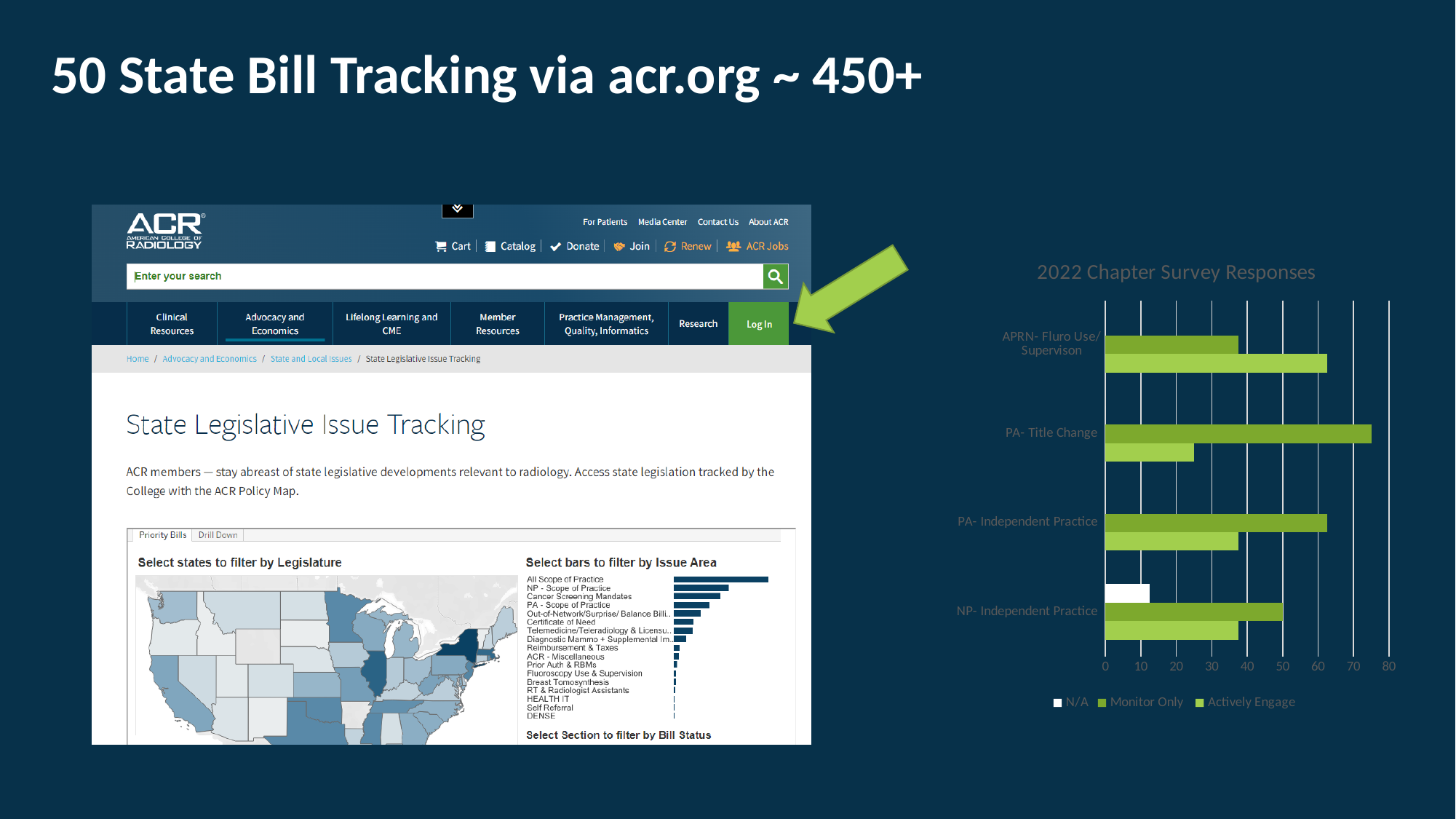
In the "2022 Chapter Survey Responses" chart, which category has the lowest Actively Engage value? PA- Title Change In the "2022 Chapter Survey Responses" chart, for PA- Title Change, which is larger: Monitor Only or Actively Engage? Monitor Only In the "2022 Chapter Survey Responses" chart, for APRN- Fluro Use/Supervison, which is larger: Monitor Only or Actively Engage? Actively Engage How many series does the legend of the "2022 Chapter Survey Responses" chart list? 3 In the "2022 Chapter Survey Responses" chart, is the N/A value for NP- Independent Practice greater or less than 20? less How many categories are shown on the "2022 Chapter Survey Responses" chart? 4 In the "2022 Chapter Survey Responses" chart, which category is the only one with an N/A bar? NP- Independent Practice In the "2022 Chapter Survey Responses" chart, which category has the highest Monitor Only value? PA- Title Change What kind of chart is the "2022 Chapter Survey Responses" chart on the right of the slide? Bar chart In the "2022 Chapter Survey Responses" chart, is the Actively Engage value for PA- Title Change greater or less than 30? less In the "2022 Chapter Survey Responses" chart, is the Monitor Only value for PA- Independent Practice greater or less than 50? greater